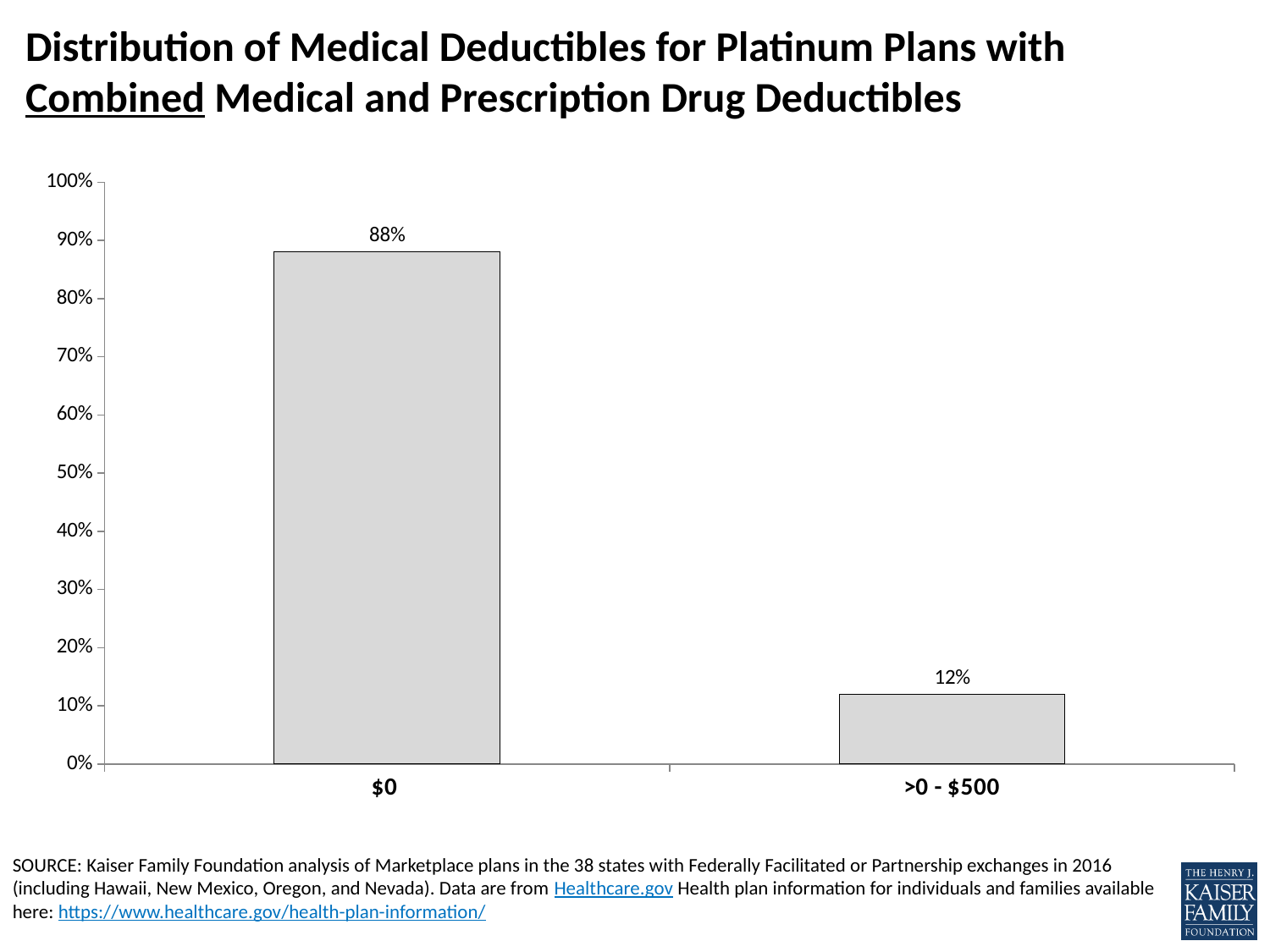
Which deductible category has the lowest share of plans? >0 - $500 What is the total of the two percentages shown on the chart? 100% What percentage of Platinum plans with combined deductibles have a $0 medical deductible? 88% What is the maximum value shown on the vertical axis? 100% Which category has a larger share: $0 or >0 - $500? $0 Which deductible category has the highest share of plans? $0 What percentage of Platinum plans with combined deductibles have a medical deductible of >0 - $500? 12% What type of chart is shown on the slide? Bar chart What is the difference in percentage points between the $0 category and the >0 - $500 category? 76 percentage points Is the value for the $0 category greater or less than 80%? greater How many deductible categories are shown on the chart? 2 Is the value for the >0 - $500 category greater or less than 20%? less